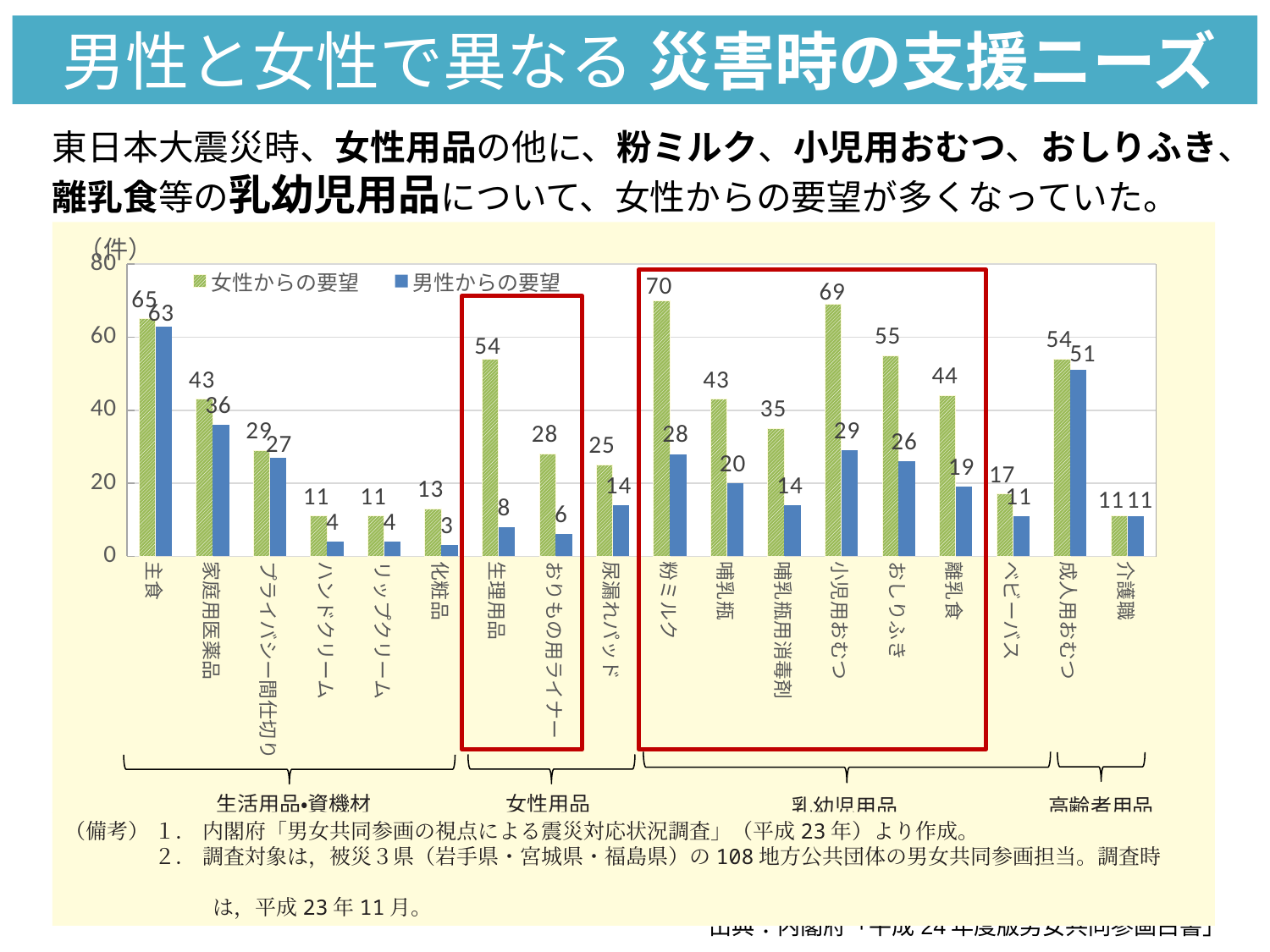
Which is larger for 成人用おむつ: 女性からの要望 or 男性からの要望? 女性からの要望 What unit is shown at the top of the y axis? （件） How many categories are shown on the x axis of the chart? 18 What is the value of 女性からの要望 for 粉ミルク? 70 What kind of chart is shown on the slide? bar chart What is the difference between 女性からの要望 and 男性からの要望 for 主食? 2 What is the difference between 女性からの要望 and 男性からの要望 for 小児用おむつ? 40 What is the value of 男性からの要望 for 介護職? 11 Which category has the lowest value for 男性からの要望? 化粧品 How many series does the legend list? 2 What is the value of 男性からの要望 for 生理用品? 8 Which category has the highest value for 女性からの要望? 粉ミルク